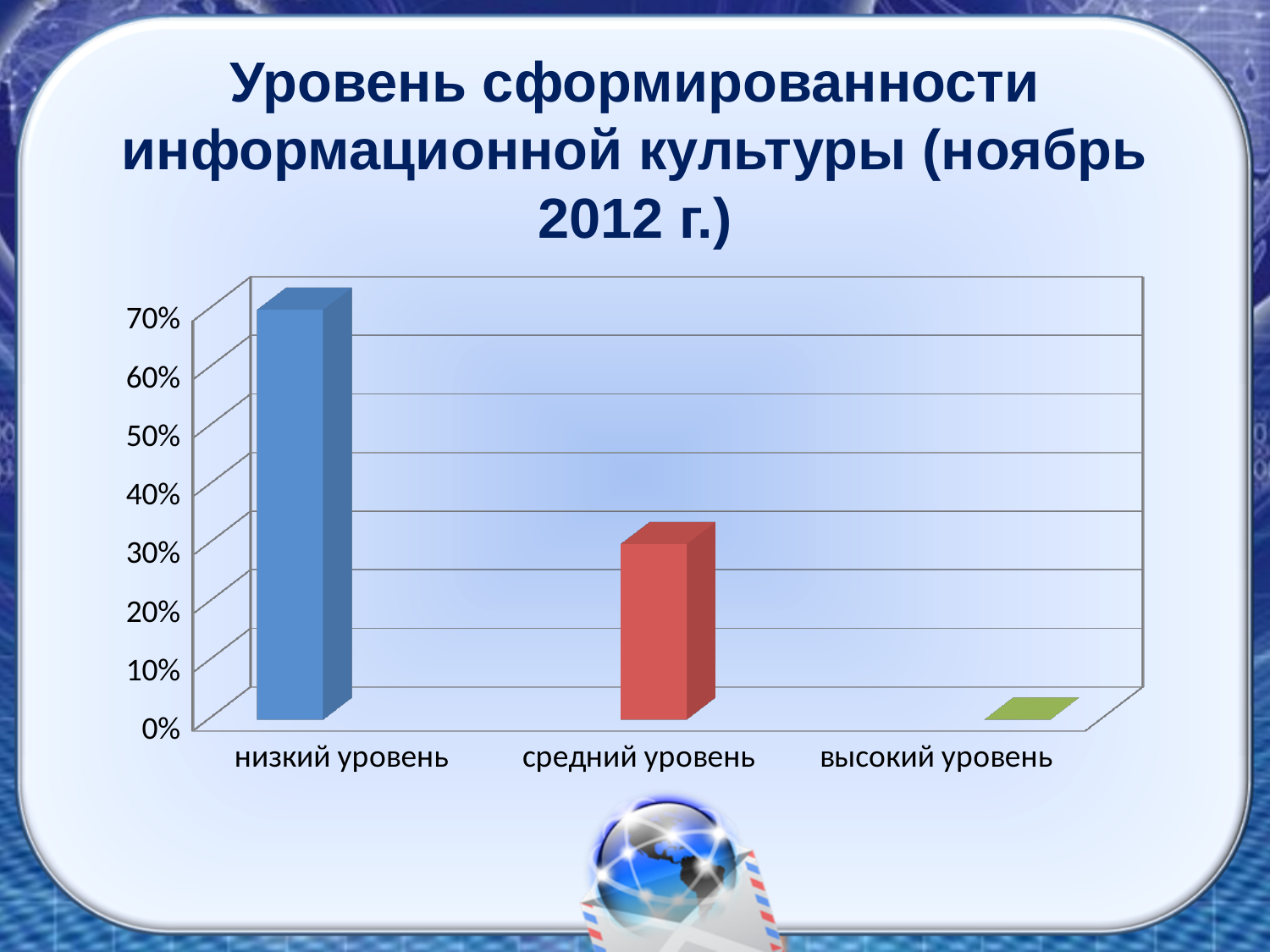
Is the value for средний уровень greater or less than 20%? greater Is the value for высокий уровень greater or less than 10%? less Is the value for средний уровень greater or less than 40%? less Which is larger, the value for средний уровень or the value for высокий уровень? средний уровень Which is larger, the value for низкий уровень or the value for средний уровень? низкий уровень Do the values rise or fall moving from left to right along the x axis? fall How many categories are shown on the x axis of the chart? 3 What is the title of the chart on the slide? Уровень сформированности информационной культуры (ноябрь 2012 г.) Which category has the lowest value in the chart? высокий уровень Which category has the highest value in the chart? низкий уровень What kind of chart is shown on the slide? bar chart